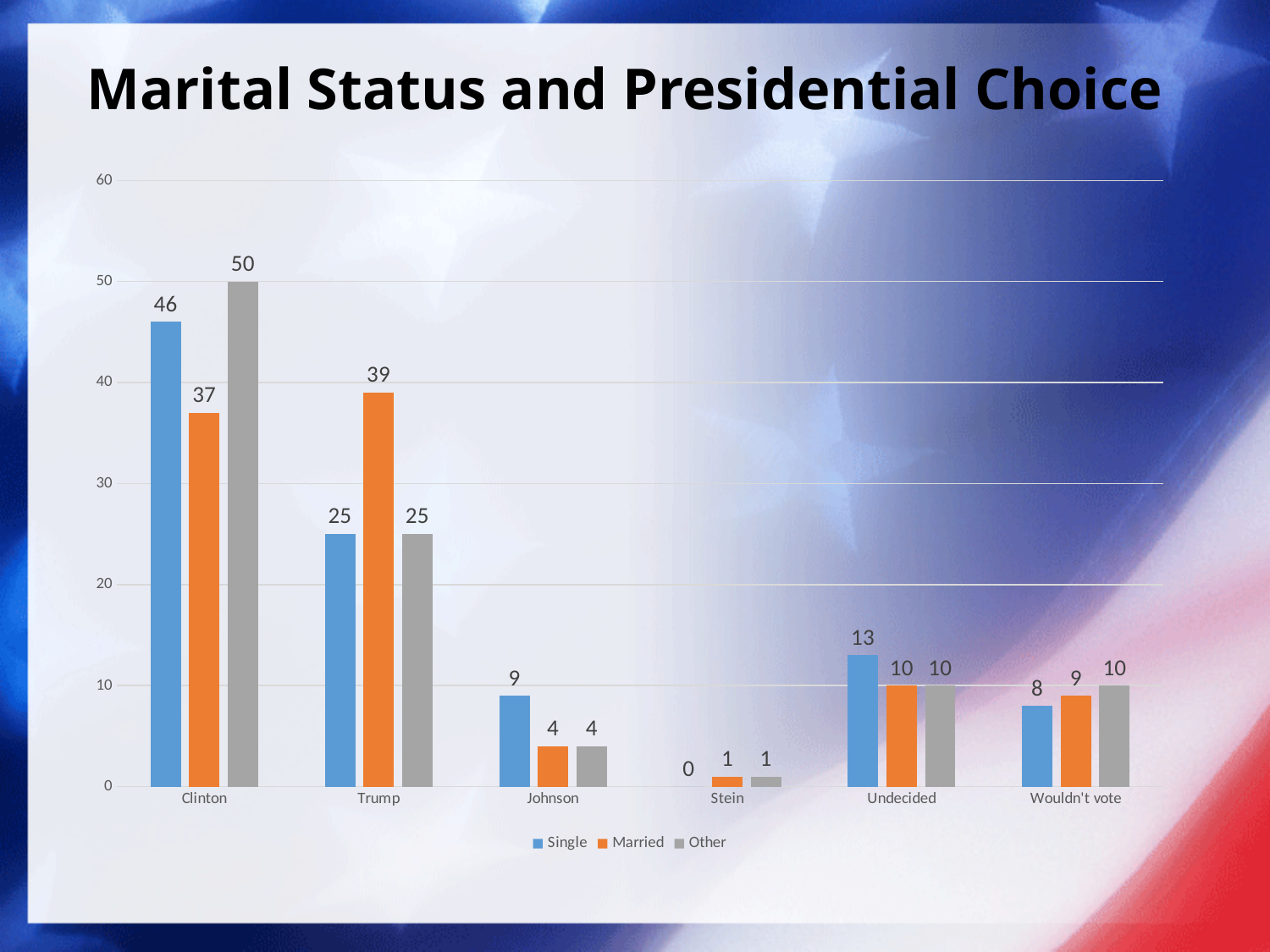
What is the difference between the Other and Married values for Clinton? 13 What is the value for Single voters who are Undecided? 13 Which category has the highest value for the Other series? Clinton Which is larger: the Single value for Trump or the Married value for Trump? Married What is the value for Married voters choosing Trump? 39 What kind of chart is shown on the slide? Bar chart What is the title of the chart? Marital Status and Presidential Choice Which category has the lowest value for the Single series? Stein What is the value for Other marital status voters choosing Johnson? 4 What is the value for Single voters choosing Clinton? 46 How many series does the legend list? 3 How many categories are shown on the x axis? 6